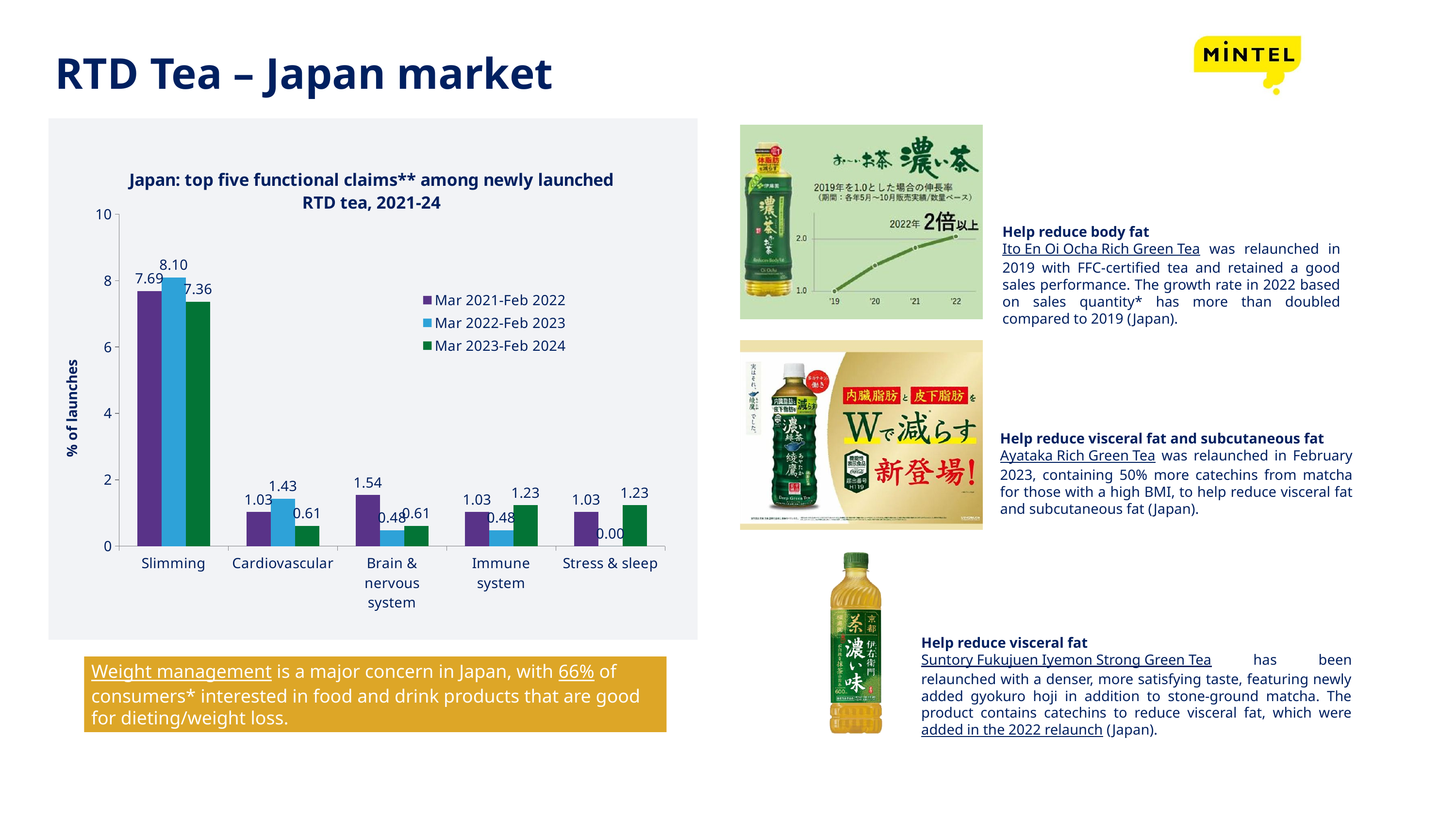
What is the value for Brain & nervous system in Mar 2021-Feb 2022? 1.54 What is the value for Stress & sleep in Mar 2022-Feb 2023? 0.00 What is the value for Slimming in Mar 2022-Feb 2023? 8.10 What is the label on the chart's vertical axis? % of launches Do the Slimming values rise or fall from Mar 2022-Feb 2023 to Mar 2023-Feb 2024? Fall What is the difference between the Slimming values for Mar 2022-Feb 2023 and Mar 2023-Feb 2024? 0.74 How many series does the chart legend list? 3 What type of chart is shown on the slide? Bar chart Which category has the lowest value in Mar 2022-Feb 2023? Stress & sleep Which is larger for Cardiovascular: the Mar 2022-Feb 2023 value or the Mar 2023-Feb 2024 value? Mar 2022-Feb 2023 Which category has the highest value in Mar 2023-Feb 2024? Slimming How many functional claim categories are shown on the x axis? 5